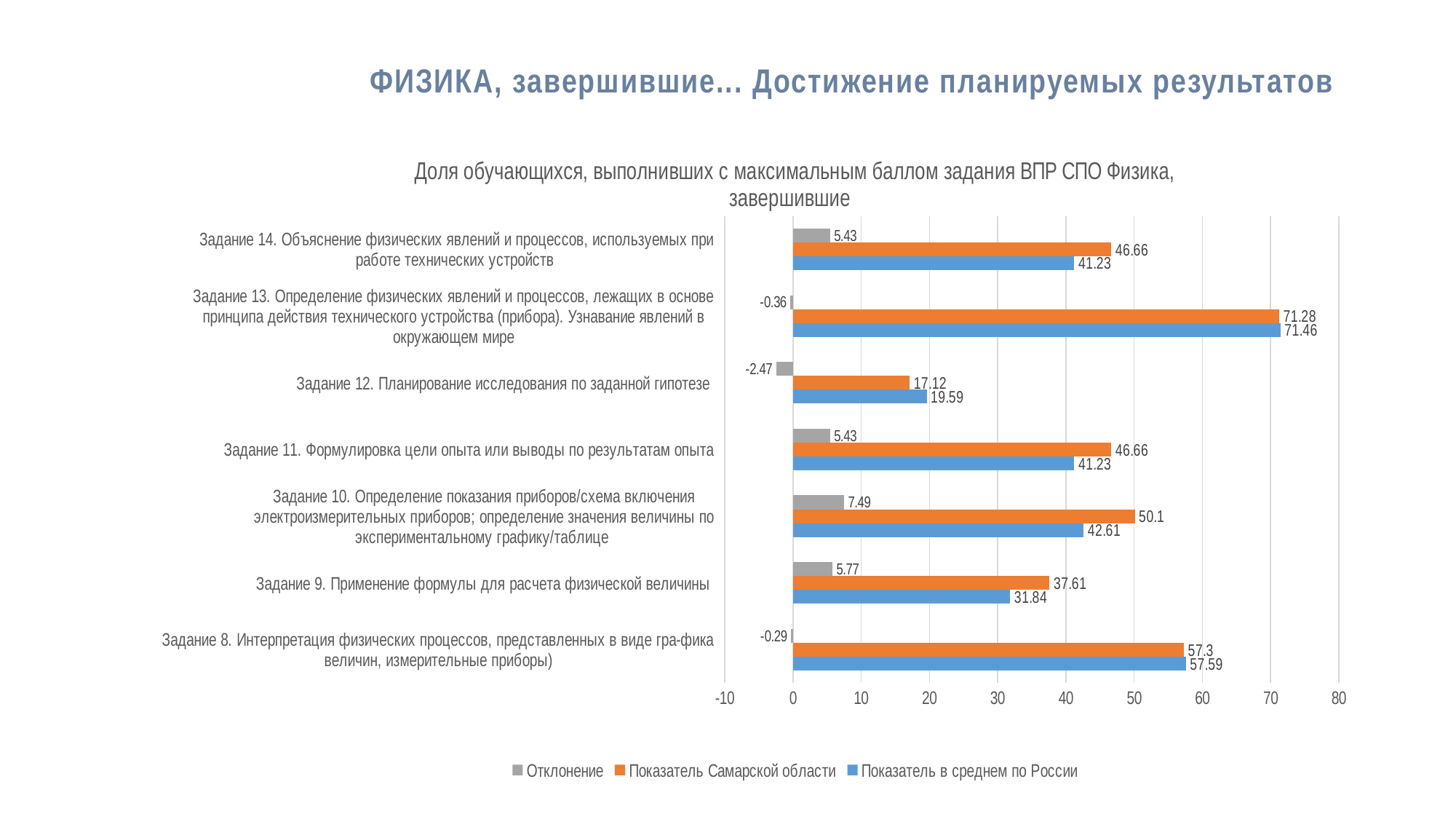
What is the Отклонение value for Задание 12? -2.47 How many tasks (categories) are shown on the chart? 7 Which task has the largest Отклонение value? Задание 10 What is the value of Показатель Самарской области for Задание 13? 71.28 How many series does the legend list? 3 Which task has the lowest value for Показатель Самарской области? Задание 12 What colour are the bars for the Отклонение series? gray What type of chart is shown on the slide? bar chart What is the difference between Показатель Самарской области and Показатель в среднем по России for Задание 10? 7.49 For Задание 8, which is larger: Показатель Самарской области or Показатель в среднем по России? Показатель в среднем по России What is the value of Показатель в среднем по России for Задание 9? 31.84 Which task has the highest value for Показатель в среднем по России? Задание 13